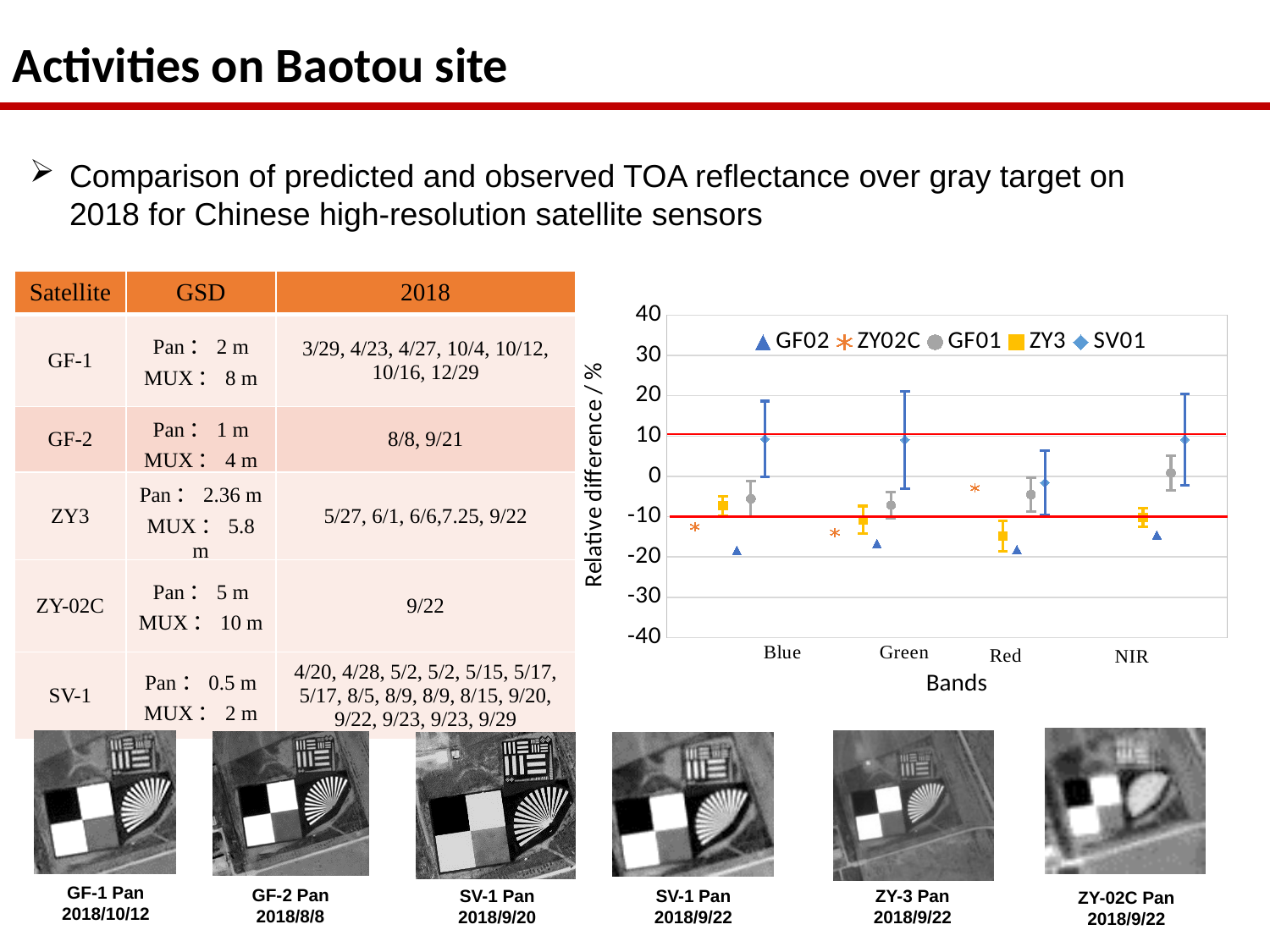
Is the value for ZY3 in the Red band greater or less than -10? less Is the value for GF02 in the Blue band greater or less than -10? less Is the value for ZY02C in the Red band greater or less than -10? greater What kind of chart is shown on the slide? scatter chart What is the label of the y axis of the chart? Relative difference / % Which series are listed in the chart legend? GF02, ZY02C, GF01, ZY3, SV01 How many bands are shown along the x axis of the chart? 4 Which series has the highest value in the Blue band? SV01 In the NIR band, which is larger, the value for GF01 or the value for GF02? GF01 How many series does the chart legend list? 5